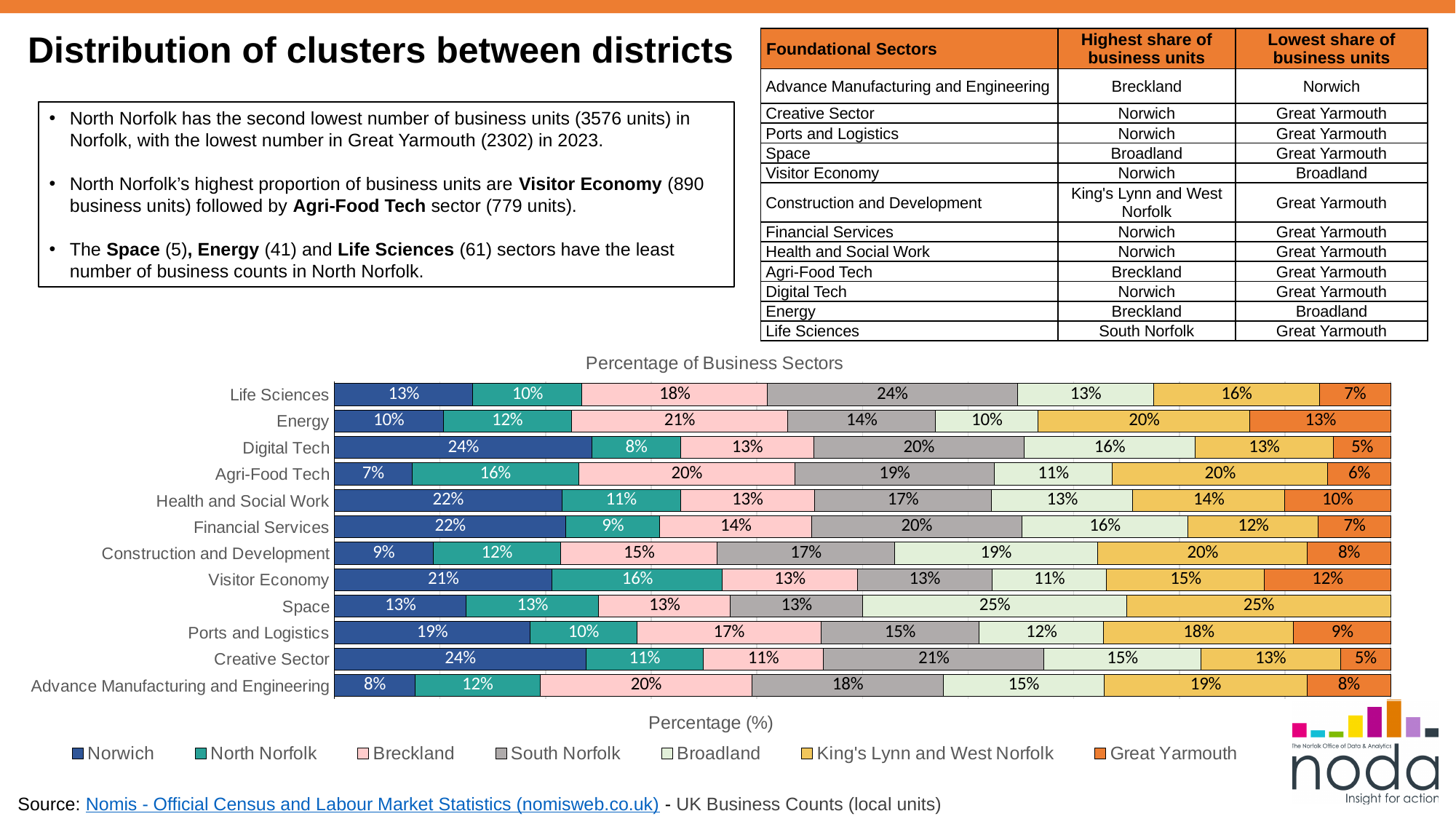
How many districts (series) does the legend of the chart list? 7 Which district has the highest share in the Life Sciences sector? South Norfolk What is the percentage for King's Lynn and West Norfolk in the Construction and Development sector? 20% What is the percentage for North Norfolk in the Visitor Economy sector? 16% How many sectors (categories) are plotted in the 'Percentage of Business Sectors' chart? 12 What is the title of the chart? Percentage of Business Sectors What is the percentage for Norwich in the Digital Tech sector? 24% What is the percentage for Great Yarmouth in the Energy sector? 13% Which district has the lowest share in the Creative Sector? Great Yarmouth What is the difference between the Norwich and Great Yarmouth percentages in the Health and Social Work sector? 12% What kind of chart is shown on the slide? Stacked bar chart In the Agri-Food Tech sector, which is larger: the share for Breckland or the share for Broadland? Breckland